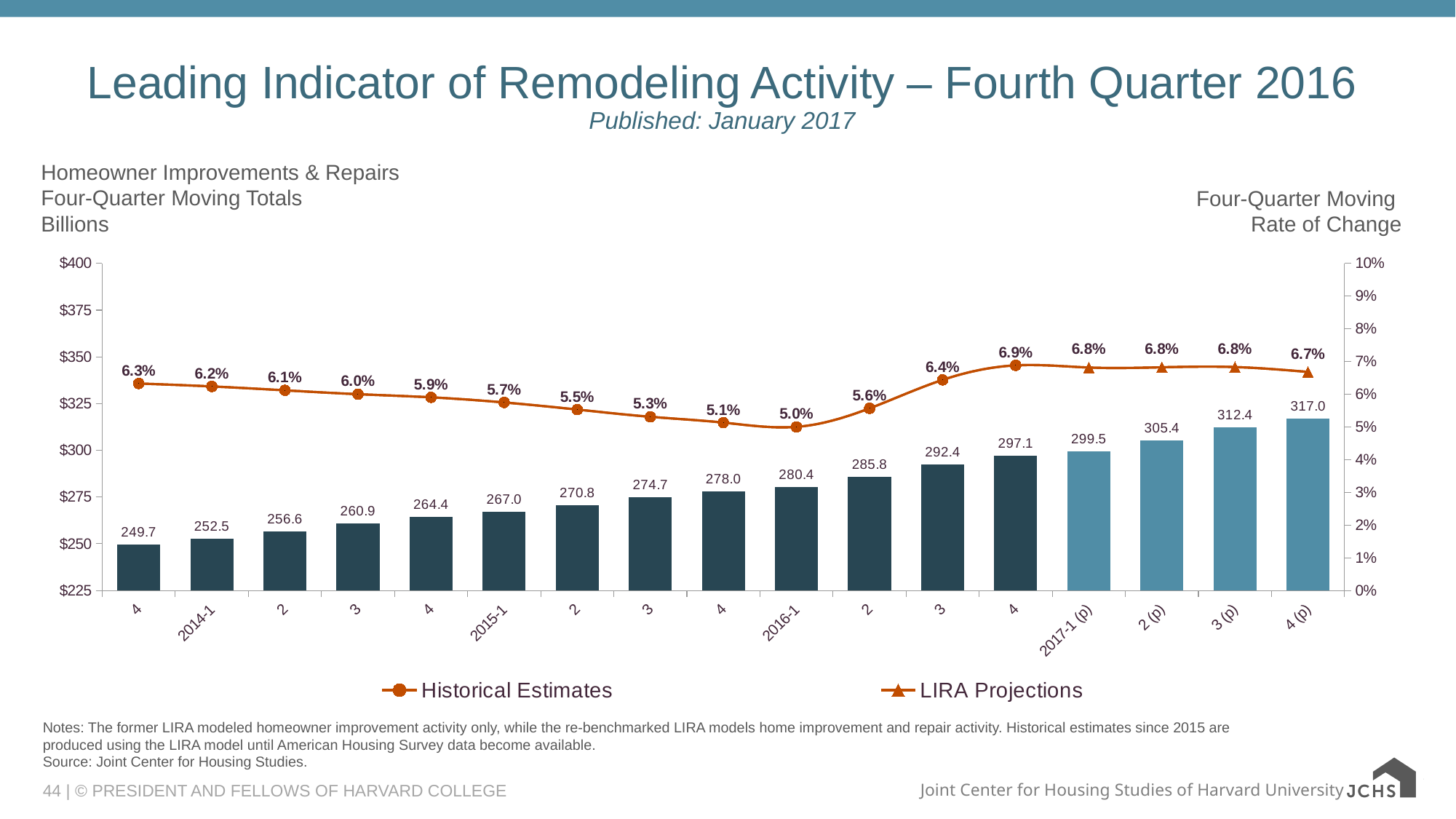
How many bars are plotted in the chart? 17 Do the four-quarter moving totals rise or fall from left to right across the chart? rise Which period has the lowest four-quarter moving rate of change? 2016-1 (5.0%) Which is larger, the four-quarter moving total for 2015-1 or for 2016-1? 2016-1 What are the two series named in the legend? Historical Estimates and LIRA Projections What is the four-quarter moving rate of change shown for 2014-1? 6.2% What is the four-quarter moving rate of change shown for 2017-1 (p)? 6.8% How many series does the legend list? 2 Which period has the highest four-quarter moving rate of change? 2016 quarter 4 (6.9%) What is the four-quarter moving total (in billions) for 2016-1? 280.4 What is the difference in four-quarter moving totals between 4 (p) and 2017-1 (p)? 17.5 What is the four-quarter moving total (in billions) for 4 (p)? 317.0